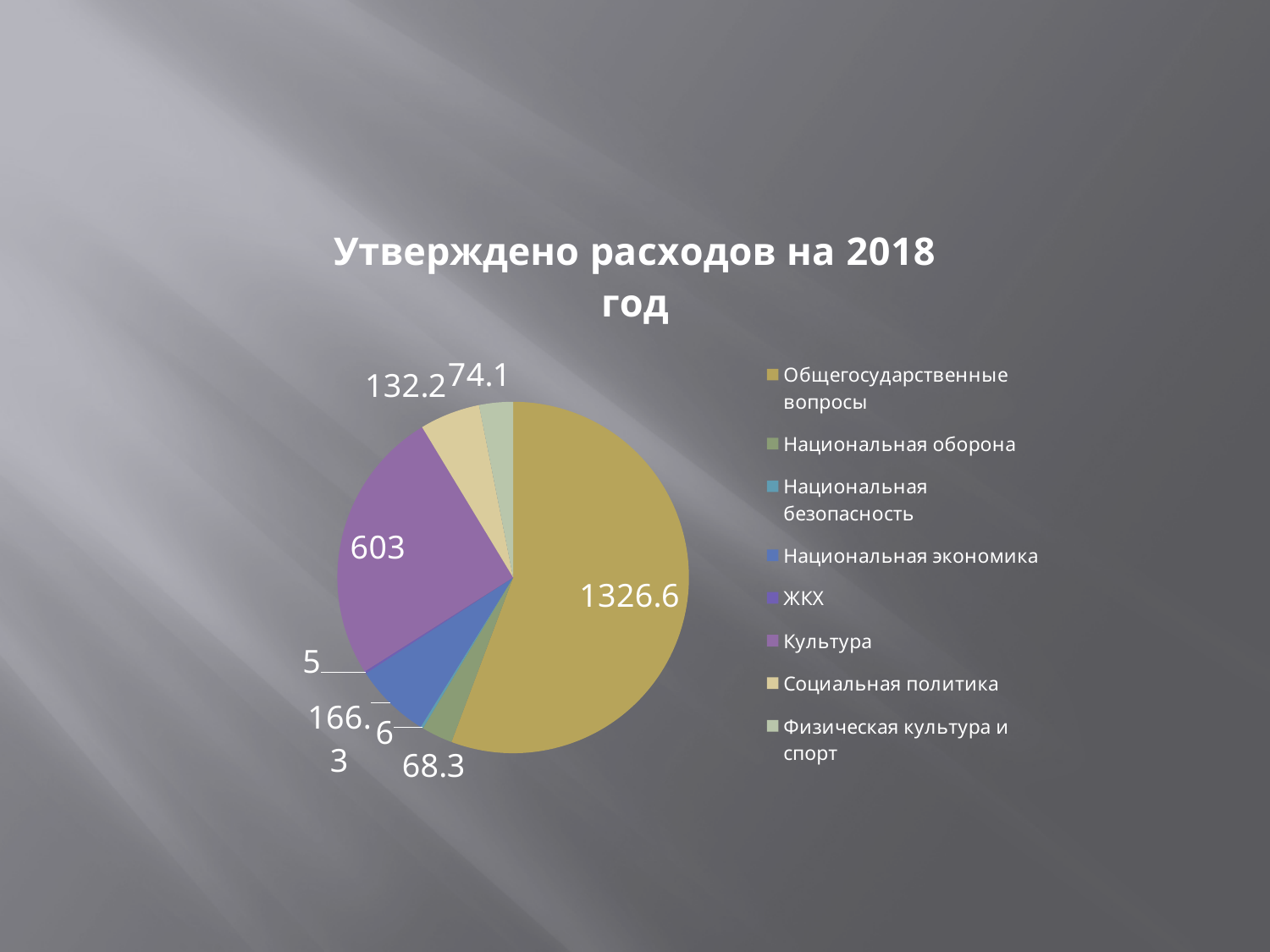
How many categories does the legend list? 8 Which category has the largest slice? Общегосударственные вопросы What is the value for Физическая культура и спорт? 74.1 What is the value for Национальная экономика? 166.3 Which is larger, Социальная политика or Физическая культура и спорт? Социальная политика What is the value for Общегосударственные вопросы? 1326.6 What is the difference between the values for Общегосударственные вопросы and Культура? 723.6 What is the title of the chart? Утверждено расходов на 2018 год What is the value for Национальная оборона? 68.3 What is the value for Социальная политика? 132.2 What is the value for Культура? 603 What kind of chart is shown on the slide? pie chart